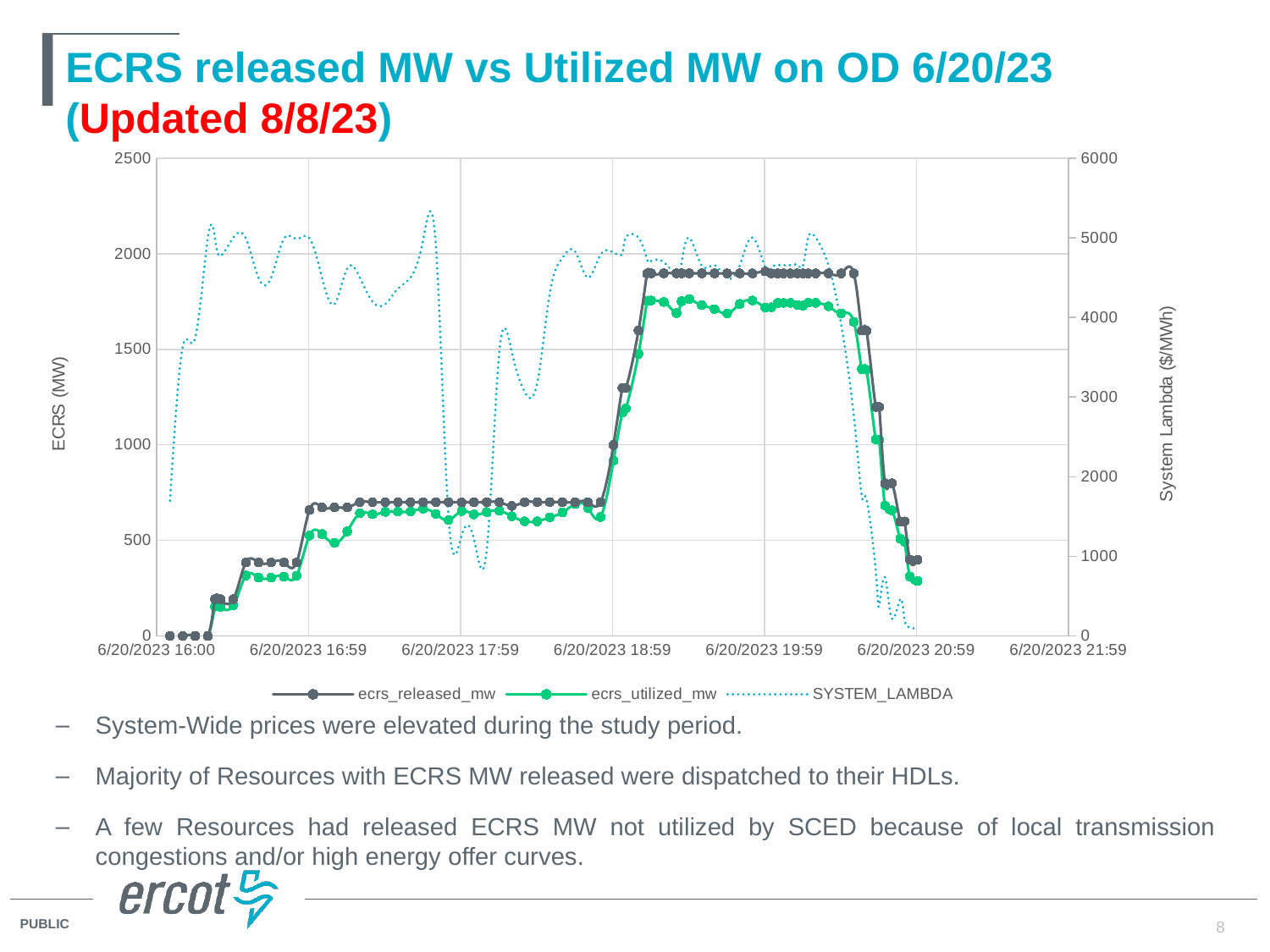
Is the value of ecrs_released_mw at 6/20/2023 16:59 greater or less than 500? greater Is the value of ecrs_released_mw at 6/20/2023 19:59 greater or less than 1500? greater Is the value of ecrs_utilized_mw at 6/20/2023 17:59 greater or less than 1000? less Does ecrs_utilized_mw rise or fall between 6/20/2023 19:59 and 6/20/2023 20:59? fall What kind of chart is shown on the slide? line chart What is the label of the left vertical axis? ECRS (MW) What is the maximum value shown on the right vertical axis? 6000 At 6/20/2023 19:59, which is larger: ecrs_released_mw or ecrs_utilized_mw? ecrs_released_mw Does ecrs_released_mw rise or fall between 6/20/2023 16:00 and 6/20/2023 18:59? rise What is the label of the right vertical axis? System Lambda ($/MWh) How many series does the legend list? 3